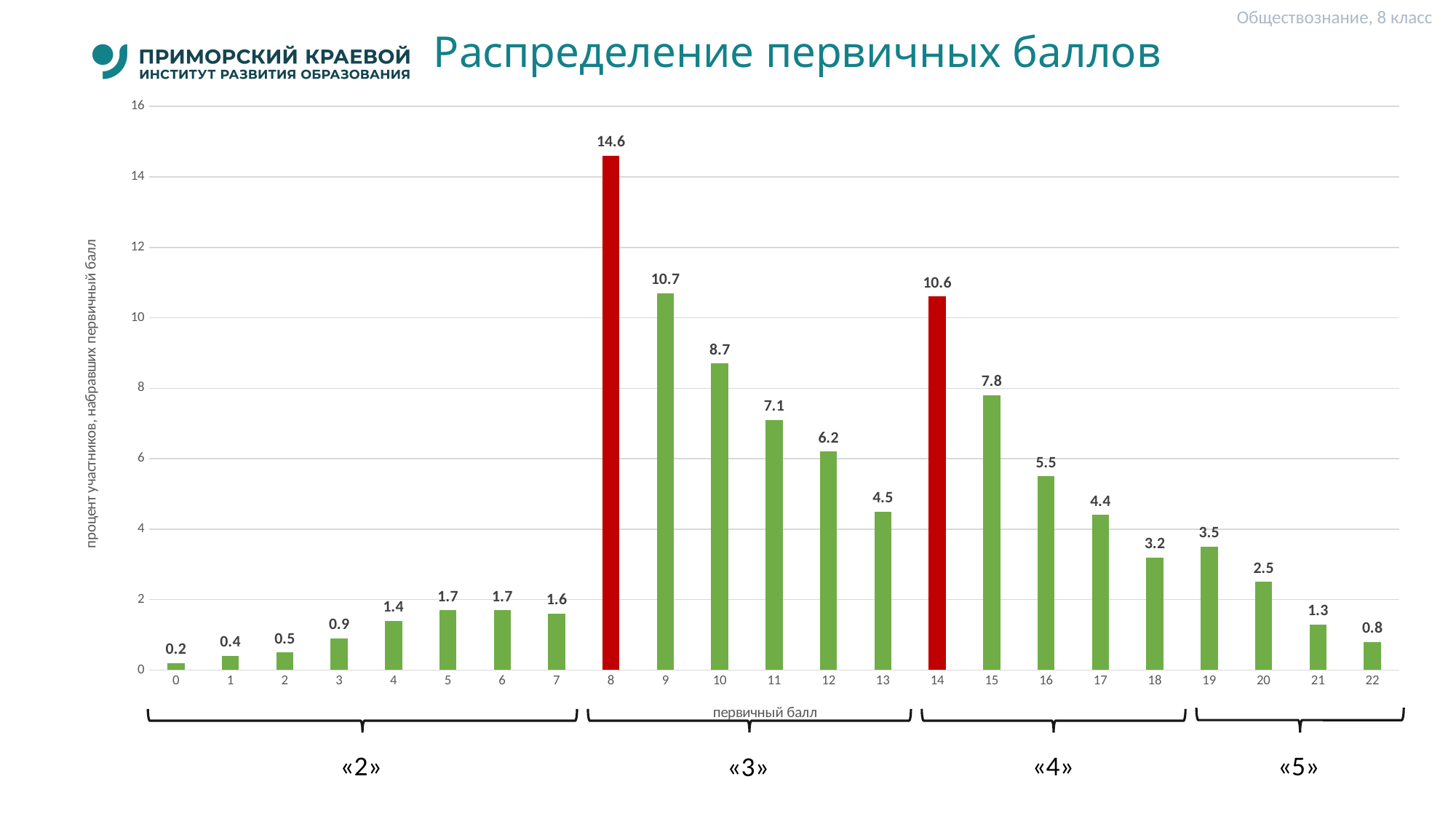
What kind of chart is shown on the slide? bar chart What is the value for primary score 8? 14.6 What is the difference between the values for primary scores 8 and 9? 3.9 Which two primary scores are highlighted with red bars? 8 and 14 Which is larger, the value for primary score 14 or for primary score 15? 14 Which primary score has the lowest value? 0 What is the value for primary score 14? 10.6 Which primary score has the highest value? 8 Do the values rise or fall along the x axis from primary score 8 to 13? fall What is the value for primary score 16? 5.5 Is the value for primary score 10 greater or less than 8? greater How many primary score categories are shown on the x axis? 23